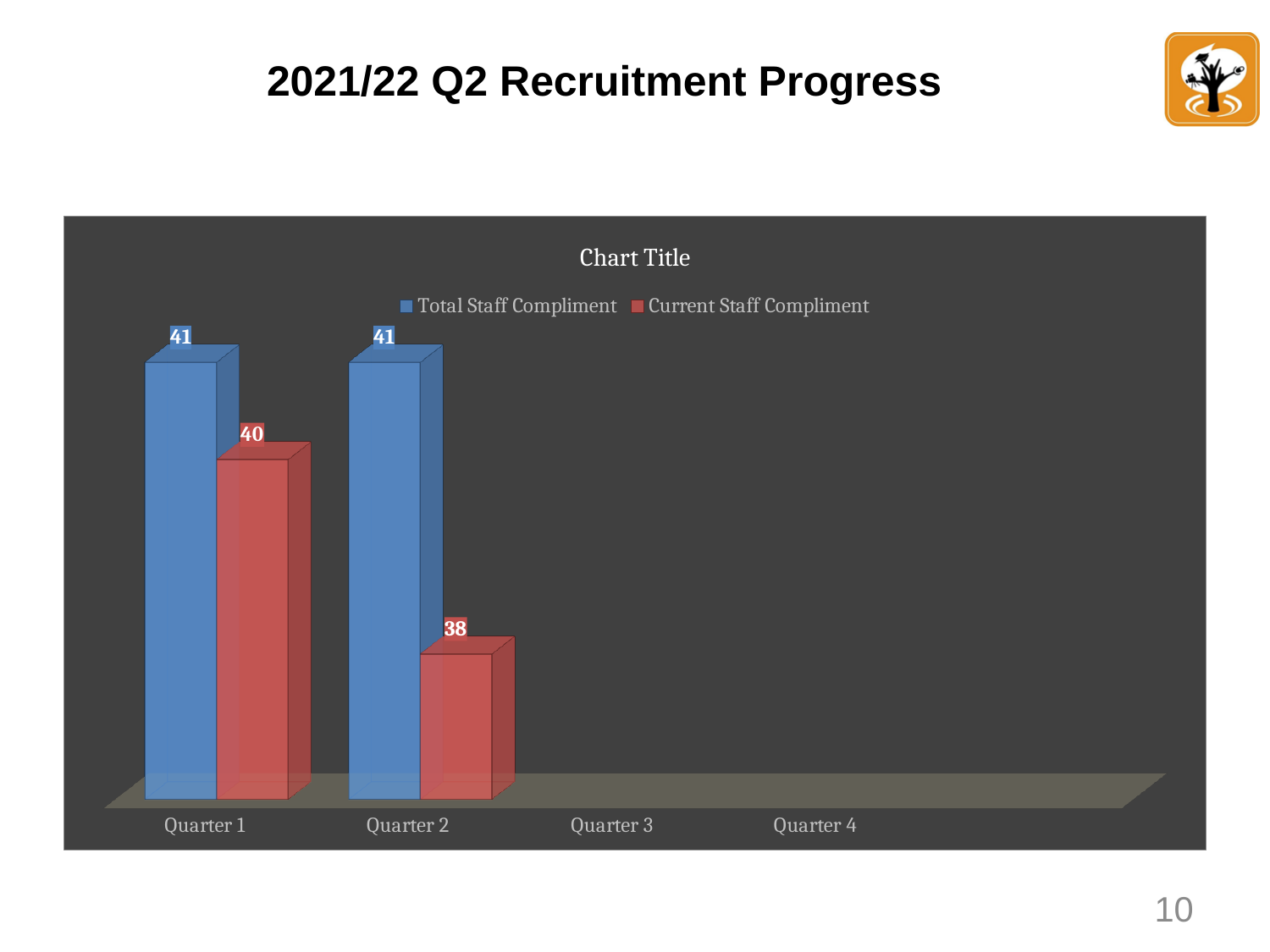
Which quarter has the lower Current Staff Compliment, Quarter 1 or Quarter 2? Quarter 2 What is the Total Staff Compliment value for Quarter 1? 41 Which quarter has the lowest Current Staff Compliment among those with plotted values? Quarter 2 What is the Current Staff Compliment value for Quarter 1? 40 How many series does the legend list? 2 What is the difference between the Total Staff Compliment and the Current Staff Compliment in Quarter 2? 3 What kind of chart is shown on the slide? Bar chart How many quarters are labelled on the x axis? 4 Which colour represents the Current Staff Compliment series? Red What is the Total Staff Compliment value for Quarter 2? 41 What is the Current Staff Compliment value for Quarter 2? 38 What is the difference between the Total Staff Compliment and the Current Staff Compliment in Quarter 1? 1